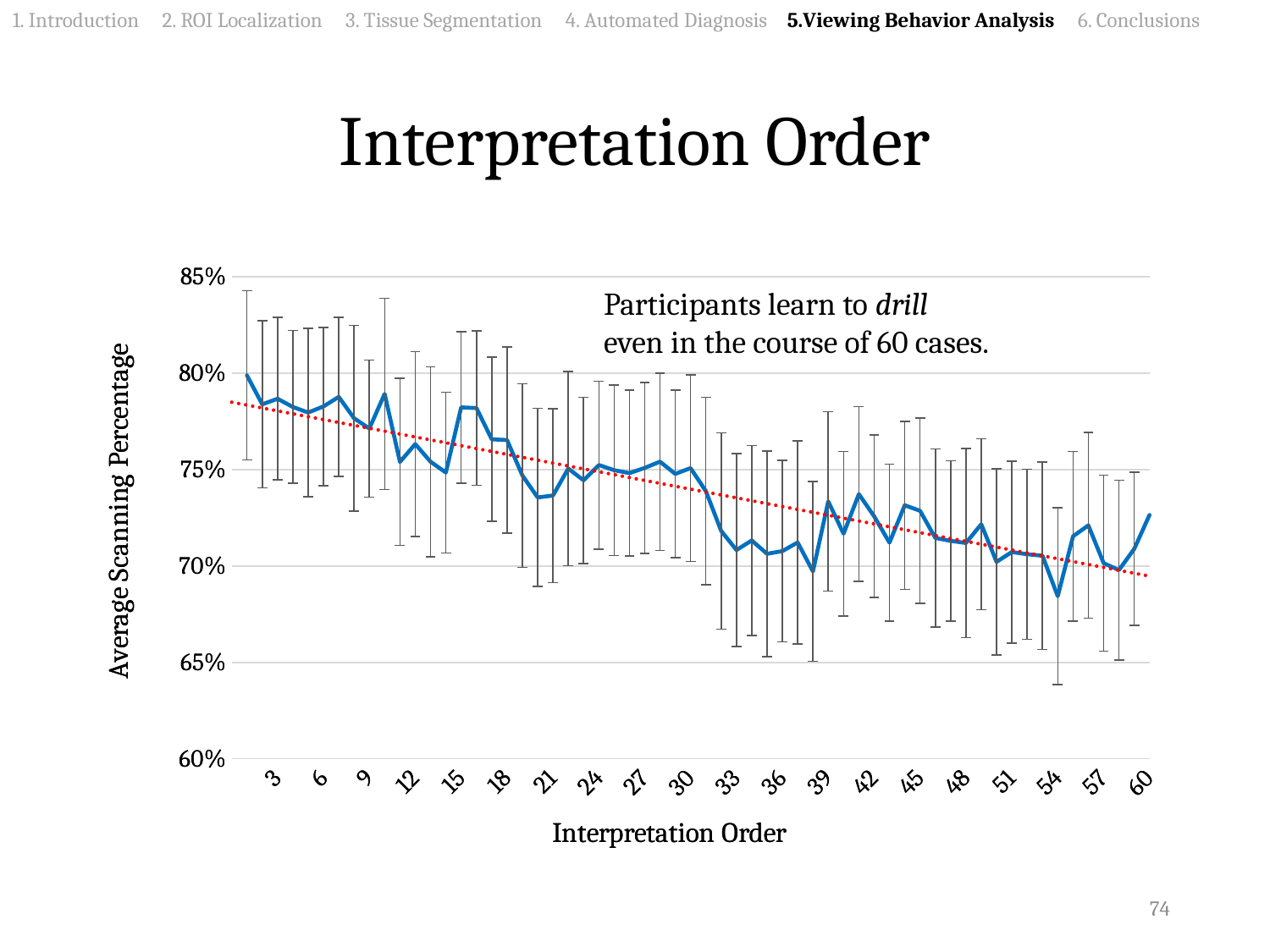
How many tick labels are shown on the x axis? 20 What is the label of the x axis? Interpretation Order Is the value for interpretation order 21 greater or less than 75%? less Is the value for interpretation order 54 greater or less than 70%? less Do the values of the blue line generally rise or fall as the interpretation order increases from 3 to 60? fall Is the value for interpretation order 60 greater or less than 70%? greater What kind of chart is shown on the slide? line chart What is the label of the y axis? Average Scanning Percentage Which has the larger average scanning percentage, interpretation order 3 or interpretation order 60? 3